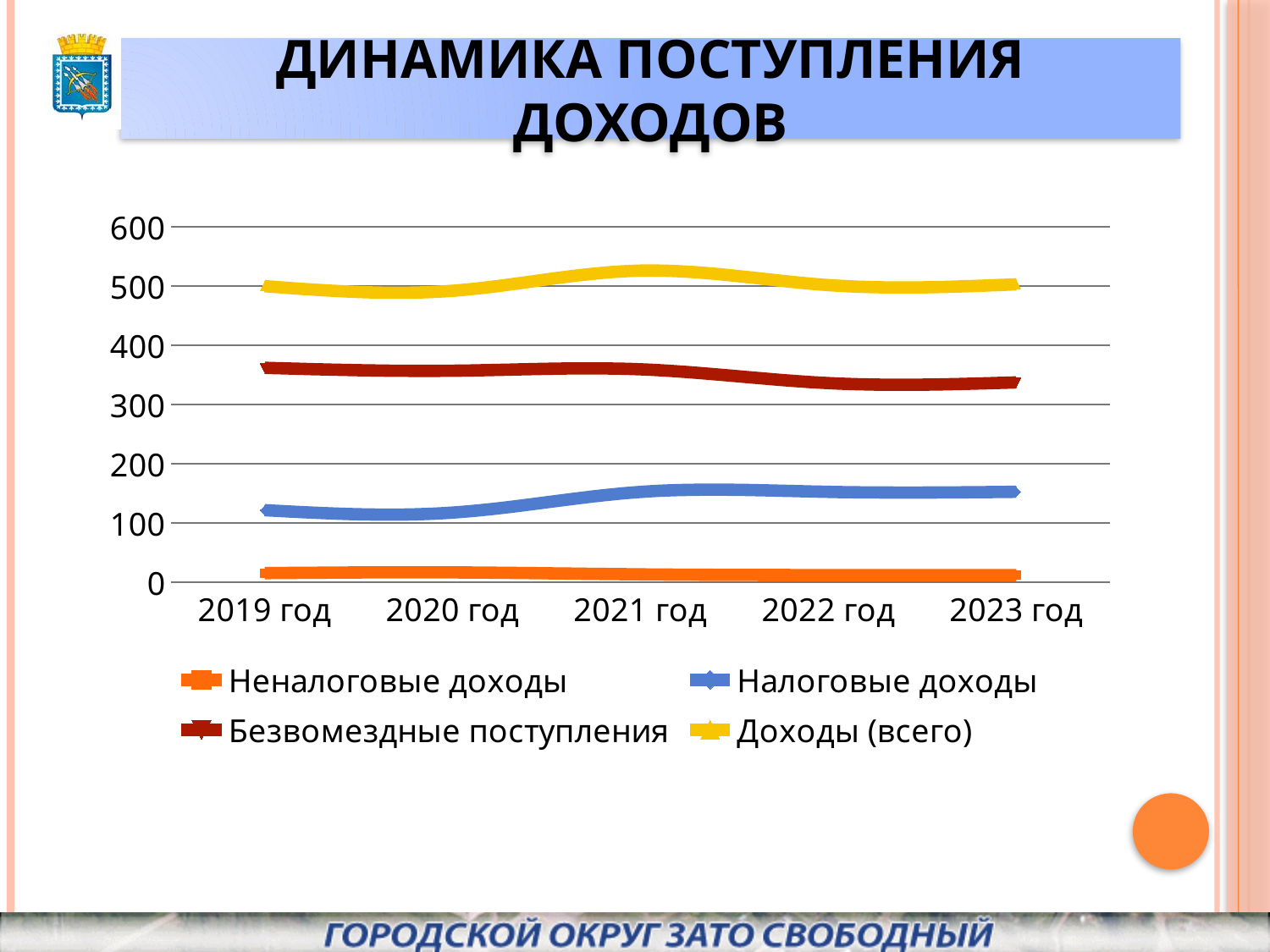
What kind of chart is shown on the slide? line chart Is the value for Безвозмездные поступления in 2022 год greater or less than 400? less How many series does the legend list? 4 In 2023 год, which is larger: Безвозмездные поступления or Налоговые доходы? Безвозмездные поступления How many years are shown on the x axis? 5 Is the value for Доходы (всего) in 2021 год greater or less than 500? greater What is the title of the chart on the slide? ДИНАМИКА ПОСТУПЛЕНИЯ ДОХОДОВ Which series has the highest values across all years? Доходы (всего) Which series has the lowest values across all years? Неналоговые доходы Is the value for Неналоговые доходы in 2023 год greater or less than 100? less Do the values for Налоговые доходы rise or fall from 2019 год to 2021 год? rise